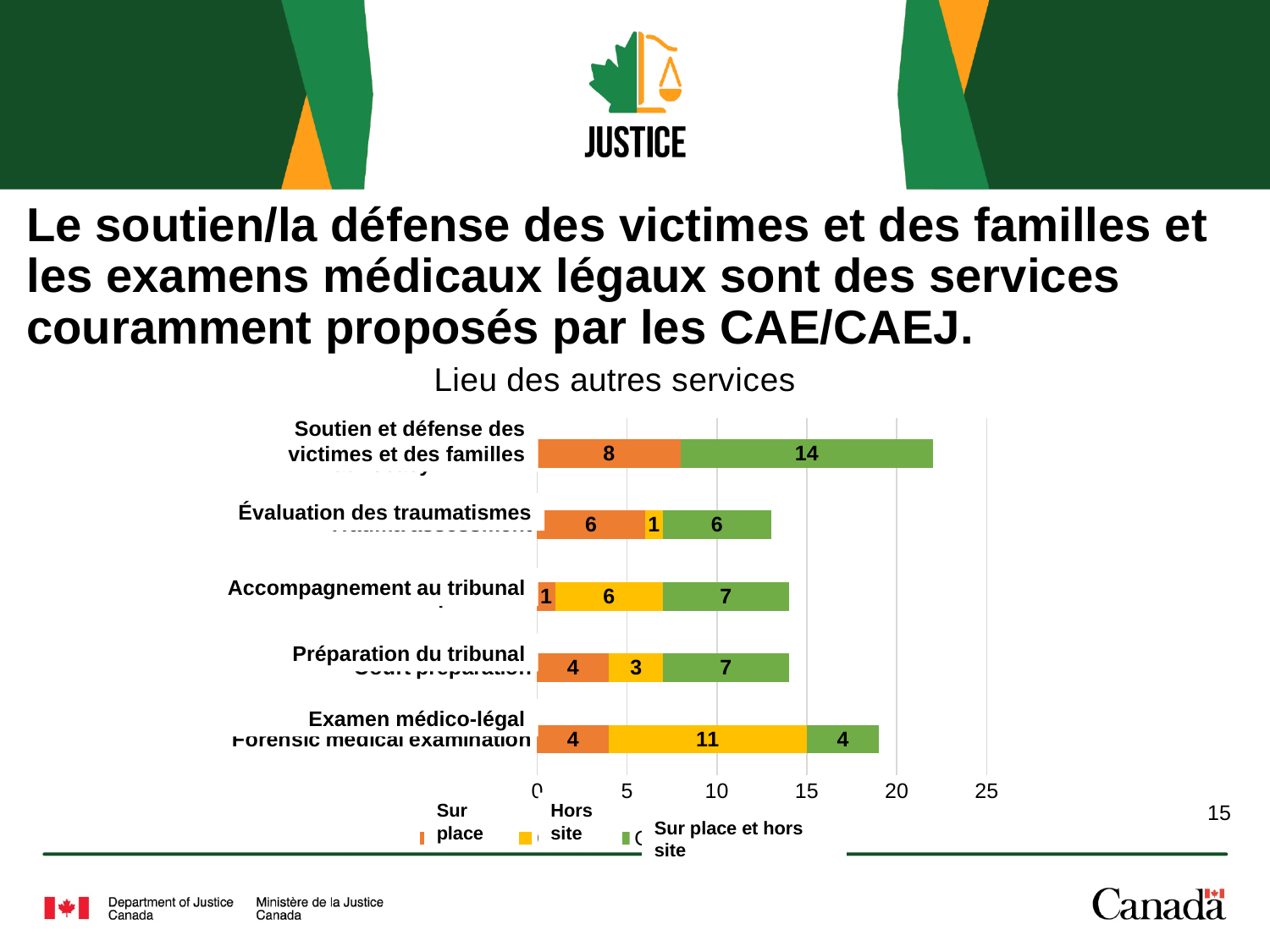
What is the 'Sur place' value for 'Évaluation des traumatismes'? 6 What kind of chart is shown on the slide? stacked bar chart What is the difference between the 'Hors site' value for 'Examen médico-légal' and the 'Hors site' value for 'Préparation du tribunal'? 8 What is the total of the stacked bar for 'Soutien et défense des victimes et des familles'? 22 What is the 'Hors site' value for 'Examen médico-légal'? 11 How many series does the legend list? 3 What is the 'Sur place et hors site' value for 'Soutien et défense des victimes et des familles'? 14 Which is larger: the 'Sur place' value for 'Soutien et défense des victimes et des familles' or the 'Sur place' value for 'Préparation du tribunal'? Soutien et défense des victimes et des familles How many categories are shown on the chart? 5 What is the title of the chart? Lieu des autres services Which category has the longest total bar? Soutien et défense des victimes et des familles What is the total of the stacked bar for 'Examen médico-légal'? 19